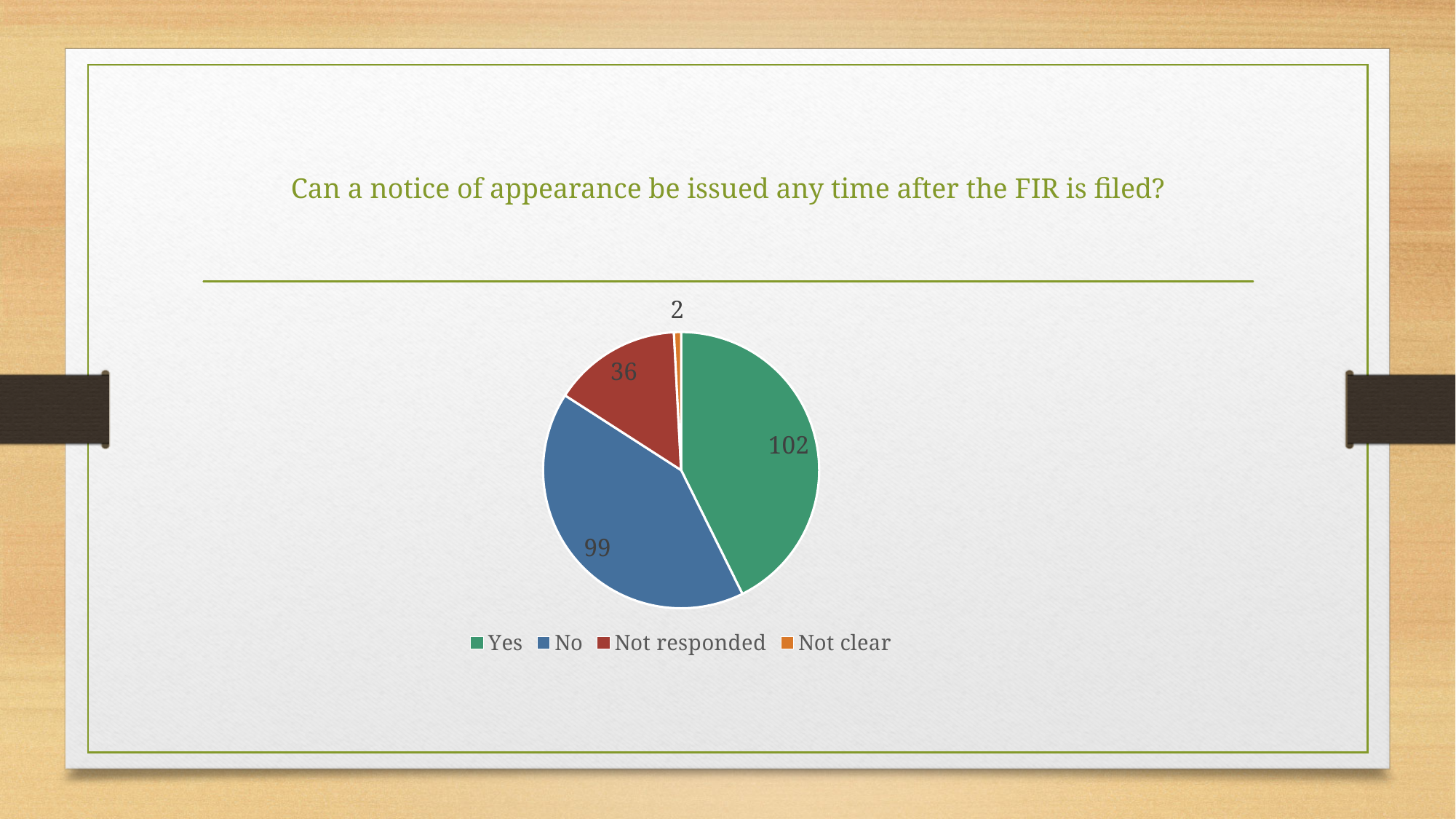
Which category has the smallest slice of the pie? Not clear Which category has the largest slice of the pie? Yes What is the value for "Not responded"? 36 What kind of chart is shown on the slide? pie chart How many respondents answered "No"? 99 How many categories does the pie chart have? 4 What colour is the "No" slice in the pie chart? blue Which is larger, the value for "Not responded" or the value for "Not clear"? Not responded What is the value for "Not clear"? 2 What is the difference between the "Yes" and "No" values? 3 How many respondents answered "Yes"? 102